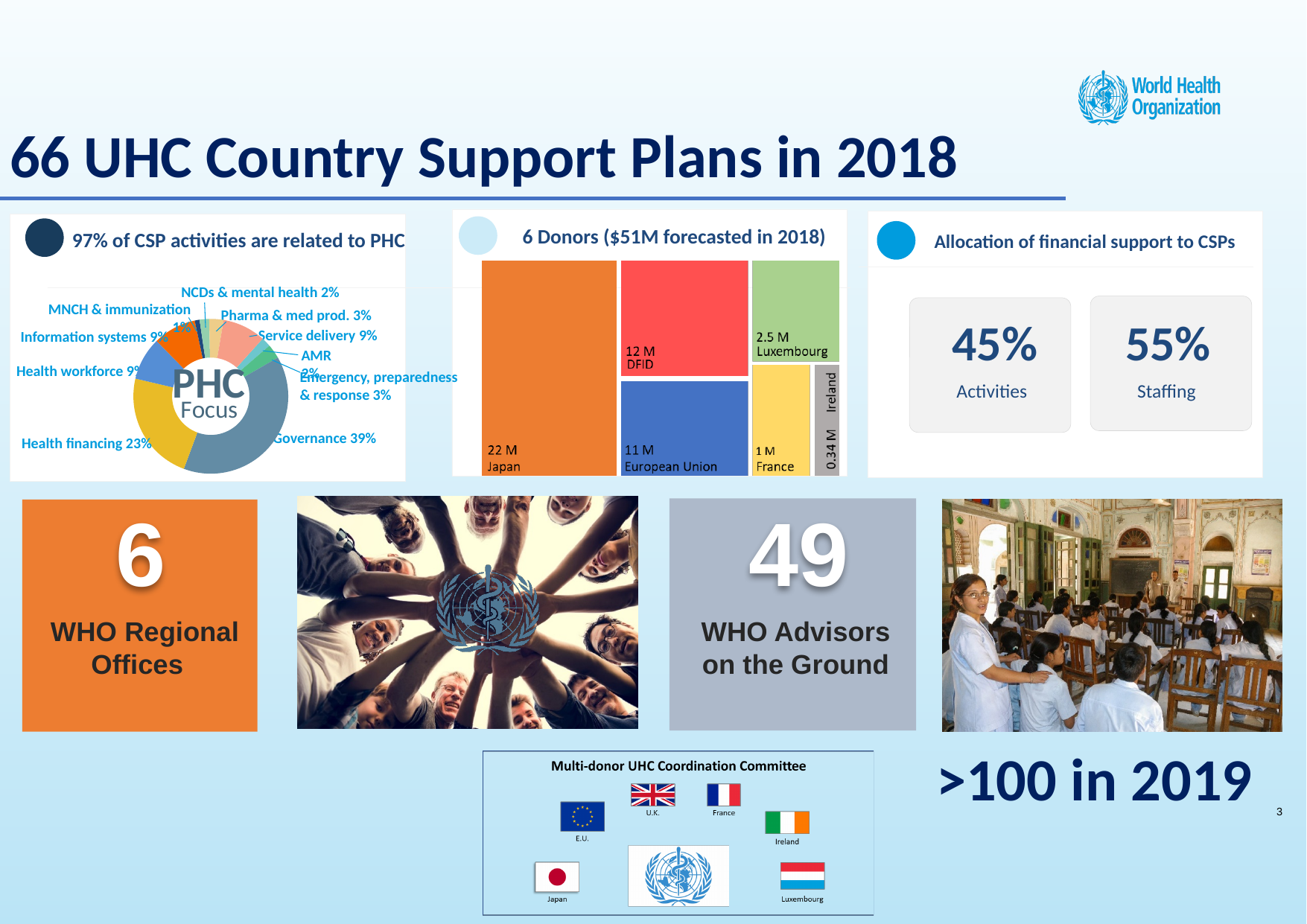
In the '97% of CSP activities are related to PHC' chart, which category has the largest share? Governance In the '6 Donors ($51M forecasted in 2018)' chart, what is the difference between the DFID and European Union amounts? 1 M In the '97% of CSP activities are related to PHC' chart, what share is Health financing? 23% In the '97% of CSP activities are related to PHC' chart, which is larger, Service delivery or Pharma & med prod.? Service delivery How many donors are shown in the '6 Donors ($51M forecasted in 2018)' chart? 6 In the '97% of CSP activities are related to PHC' chart, what share is Governance? 39% In the '6 Donors ($51M forecasted in 2018)' chart, how much is forecast from Ireland? 0.34 M In the 'Allocation of financial support to CSPs' panel, what percentage goes to Staffing? 55% In the '6 Donors ($51M forecasted in 2018)' chart, how much is forecast from Japan? 22 M In the '6 Donors ($51M forecasted in 2018)' chart, which donor contributes the least? Ireland In the '97% of CSP activities are related to PHC' chart, what is the difference between the Governance and Health financing shares? 16% What kind of chart is the '97% of CSP activities are related to PHC' chart? Donut (pie) chart